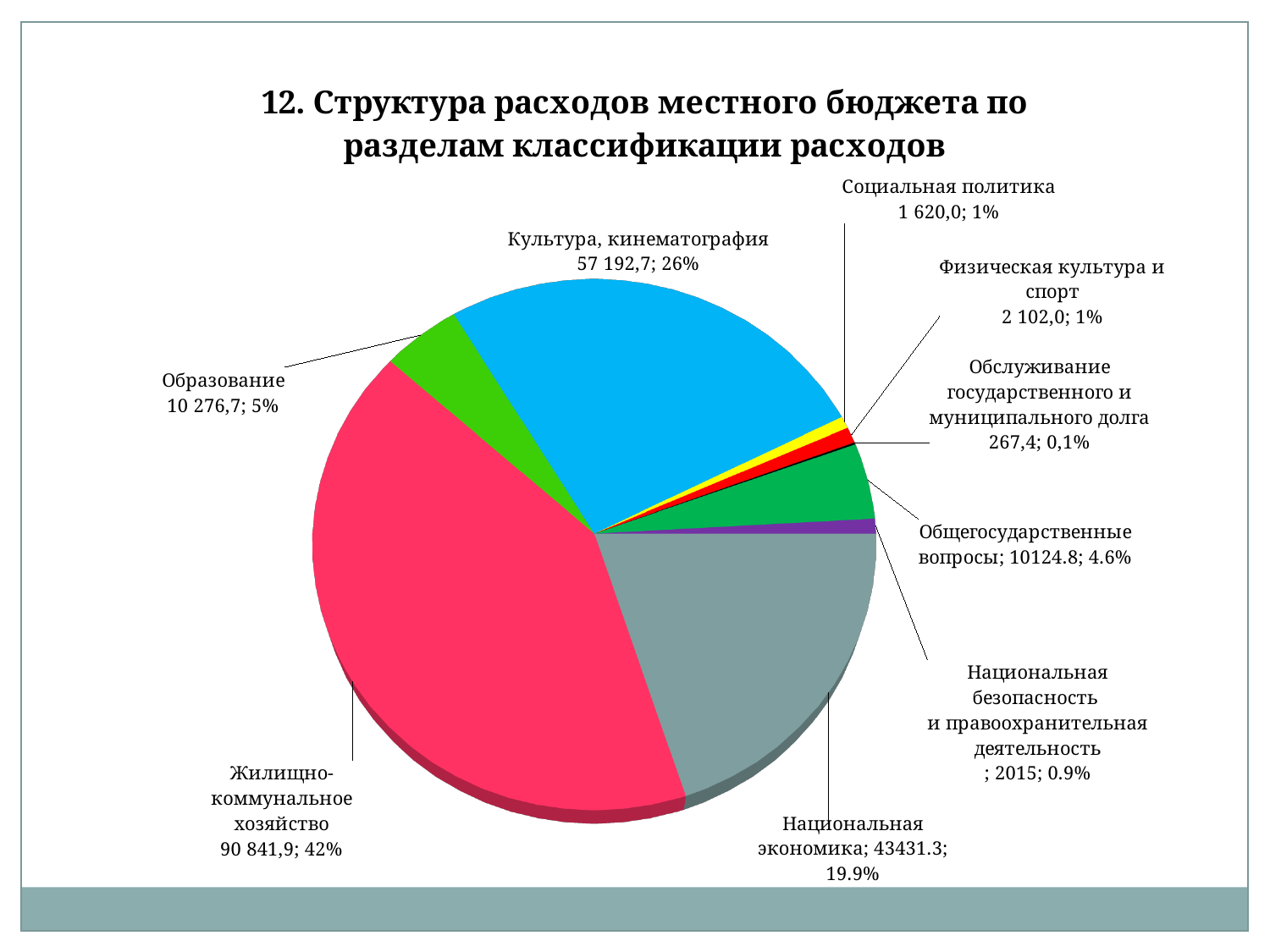
Which category has the largest share of the pie? Жилищно-коммунальное хозяйство What share of the pie does Образование represent? 5% How many categories (slices) does the pie chart have? 9 What is the value for Обслуживание государственного и муниципального долга? 267,4 Which is larger, Культура, кинематография or Национальная экономика? Культура, кинематография Which category has the smallest share of the pie? Обслуживание государственного и муниципального долга What is the value for Национальная экономика? 43431.3 What is the value for Жилищно-коммунальное хозяйство? 90 841,9 What is the value for Культура, кинематография? 57 192,7 What is the difference between the values for Жилищно-коммунальное хозяйство and Культура, кинематография? 33 649,2 What kind of chart is shown on the slide? pie chart What share of the pie does Общегосударственные вопросы represent? 4.6%